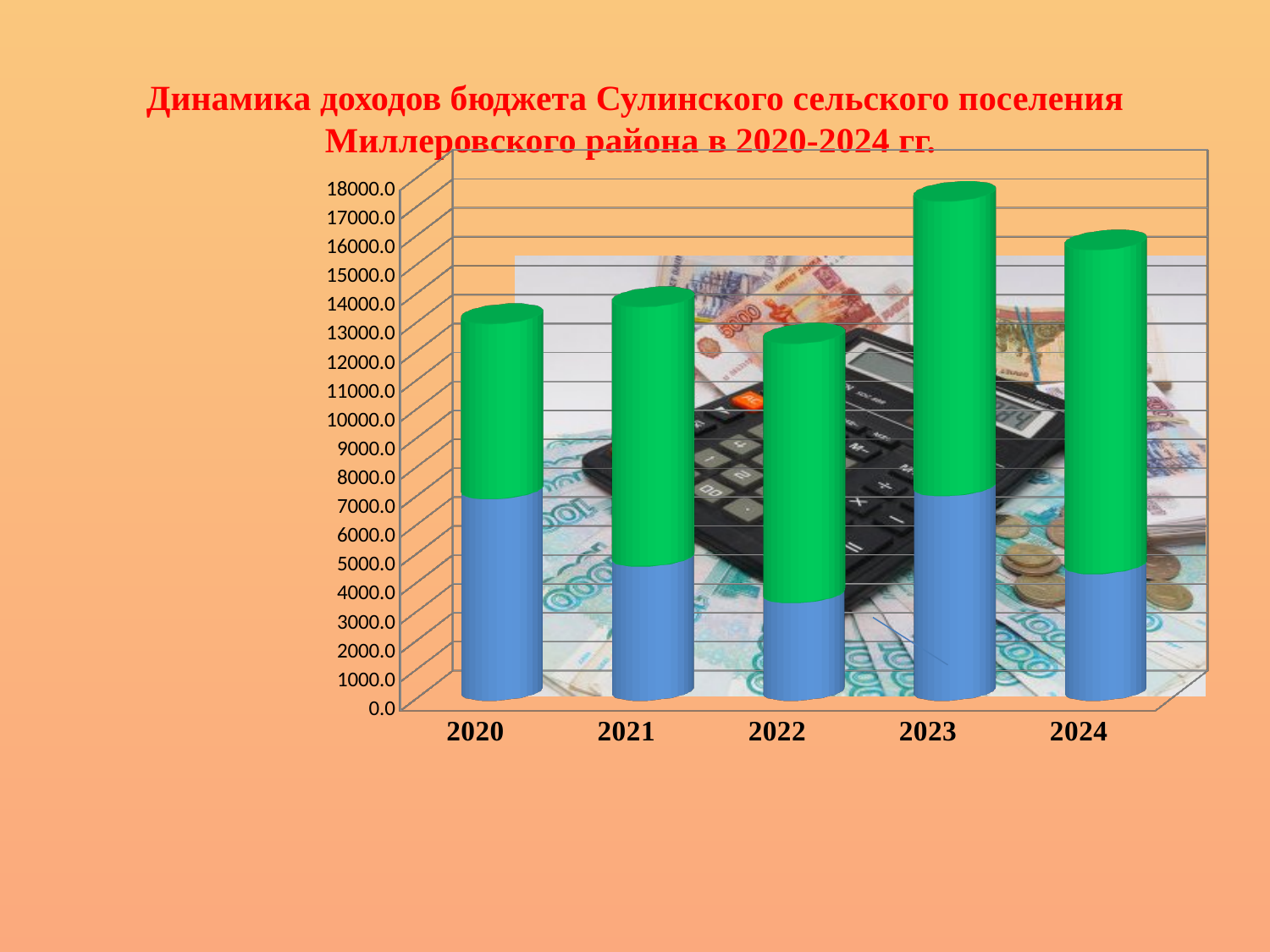
Is the blue segment for 2022 greater or less than 5000.0? less Which year has the shortest bar in the chart? 2022 Which year has the tallest bar in the chart? 2023 What kind of chart is shown on the slide? Stacked bar chart How many years are shown on the x axis of the chart? 5 Does the total bar height rise or fall from 2023 to 2024? fall Is the total bar height for 2022 greater or less than 14000.0? less Which bar is taller, 2023 or 2022? 2023 Is the blue segment for 2020 greater or less than 6000.0? greater What two colours are used for the segments of each bar? Blue and green